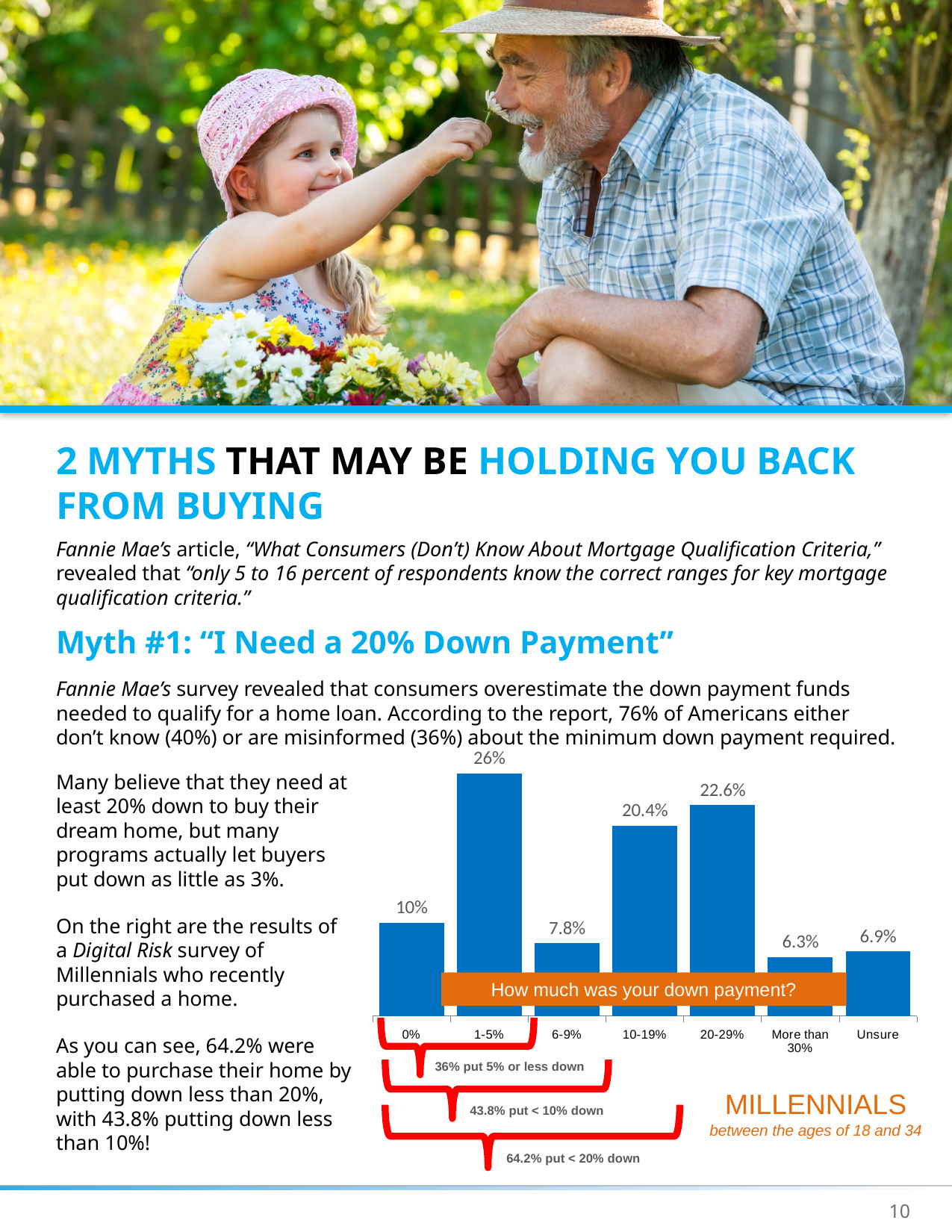
What is the difference between the 1-5% and 6-9% categories? 18.2% Which down payment category has the highest value? 1-5% Which is larger, the value for 6-9% or the value for 0%? 0% What percentage of Millennials put 20-29% down? 22.6% Which down payment category has the lowest value? More than 30% What percentage of Millennials put 0% down? 10% What is the title shown on the chart? How much was your down payment? How many down payment categories are shown on the chart? 7 What kind of chart is shown on the slide? bar chart What is the difference between the 20-29% and 10-19% categories? 2.2% What percentage of Millennials answered Unsure? 6.9% What percentage of Millennials put 1-5% down? 26%